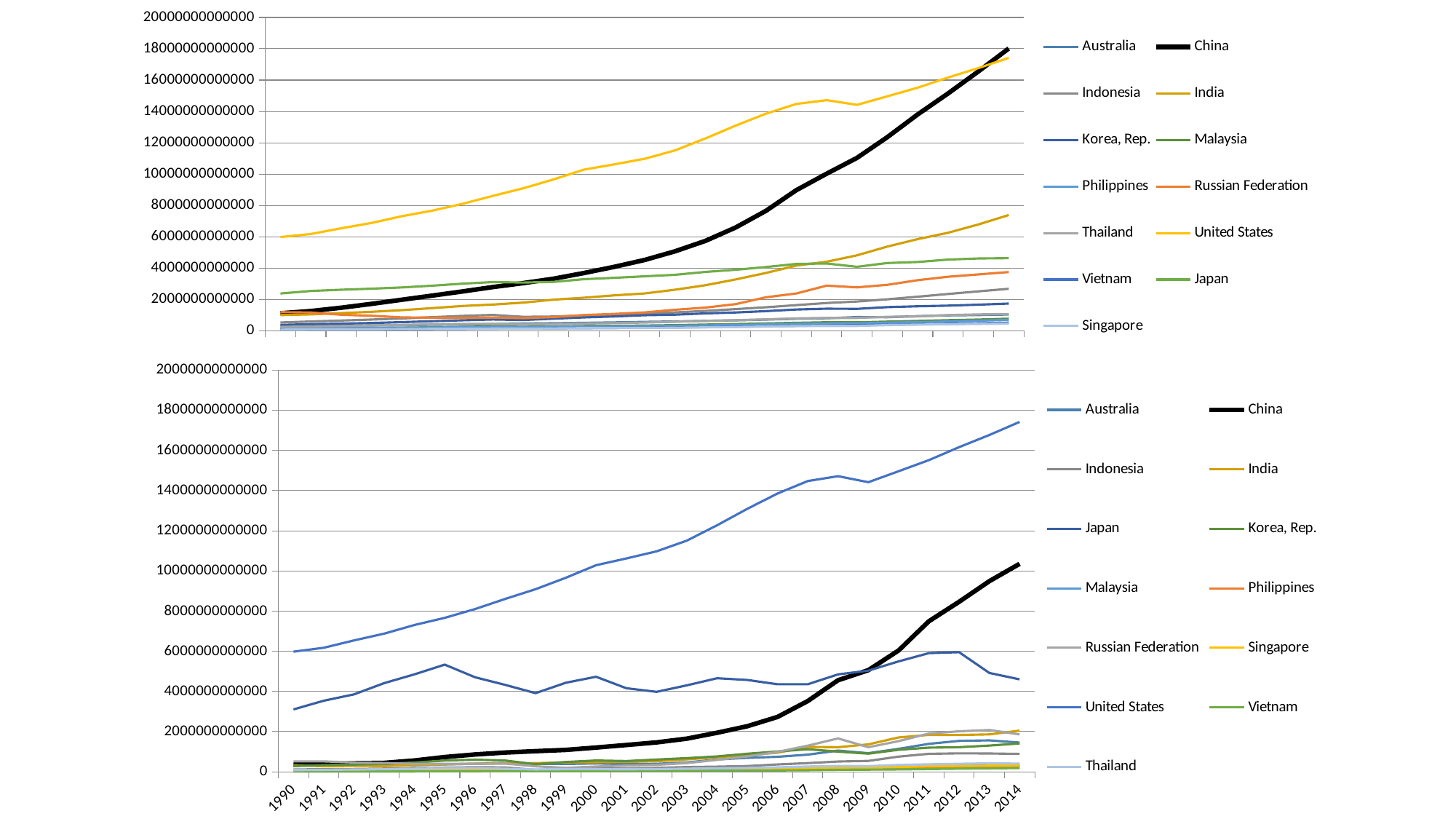
In the bottom chart, how many years are shown on the x axis? 25 In the top chart, is the value for China at the right end of the x axis greater or less than 160000000000000? greater In the bottom chart, does the value for China rise or fall from 1990 to 2014? rise How many series does the legend of the top chart list? 13 In the bottom chart, is the value for Japan in 2014 greater or less than 60000000000000? less In the bottom chart, which series has the highest value in 2014? United States How many series does the legend of the bottom chart list? 13 In the top chart, which series has the highest value at the right end of the x axis? China In the bottom chart, is the value for China in 2014 greater or less than 100000000000000? greater In the bottom chart, which is larger in 2014: the value for United States or the value for China? United States In the bottom chart, what is the first year shown on the x axis? 1990 What kind of chart is the top chart on the slide? line chart